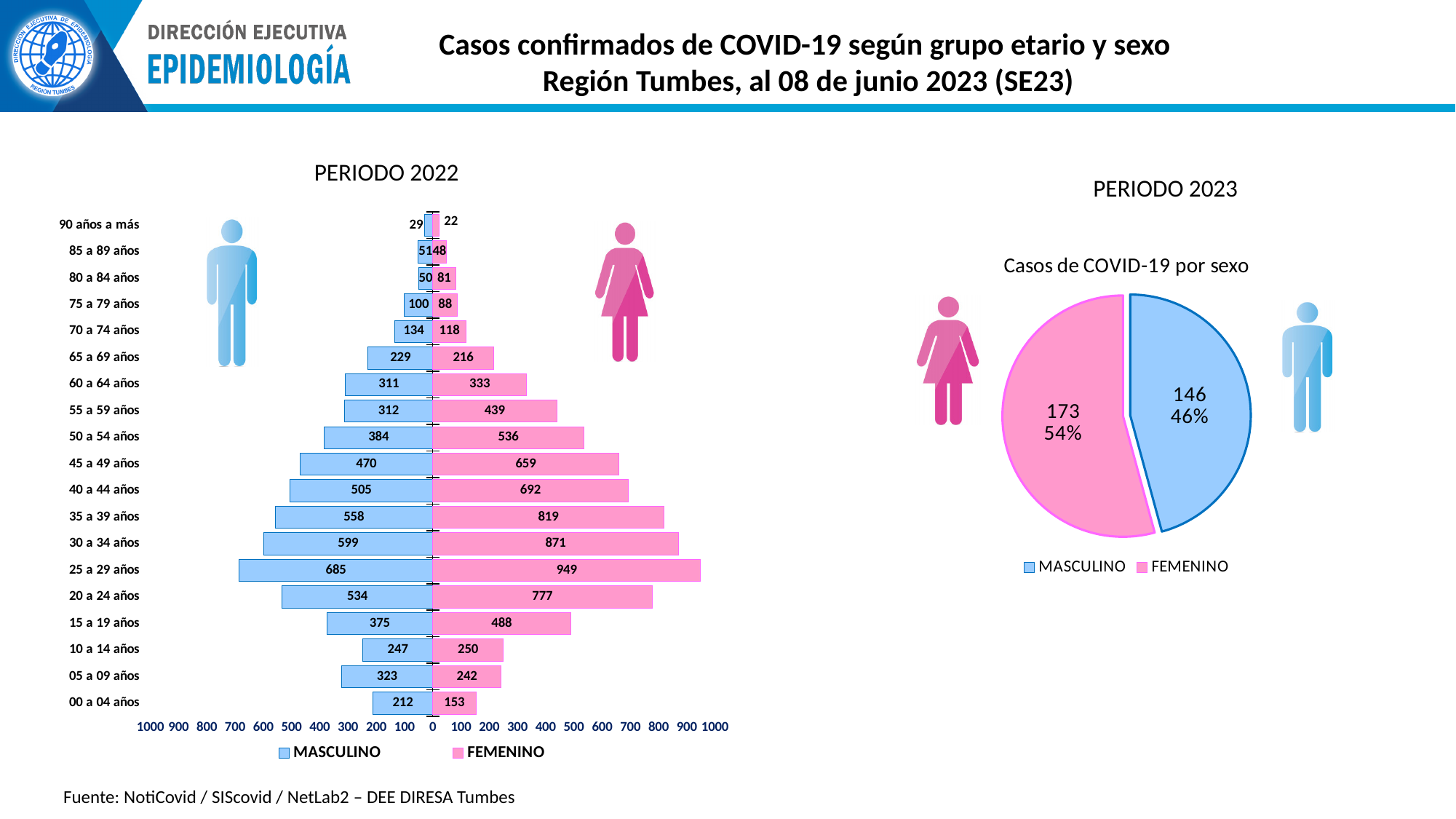
In the PERIODO 2022 chart, how many FEMENINO cases are shown for the 25 a 29 años group? 949 In the PERIODO 2022 chart, which age group has the highest number of MASCULINO cases? 25 a 29 años How many series does the legend of the PERIODO 2022 chart list? 2 What is the title of the PERIODO 2023 pie chart? Casos de COVID-19 por sexo In the PERIODO 2023 pie chart, how many MASCULINO cases are shown? 146 In the PERIODO 2022 chart, how many MASCULINO cases are shown for the 45 a 49 años group? 470 What kind of chart is the PERIODO 2022 chart? Bar chart In the PERIODO 2022 chart, which is larger for the 05 a 09 años group, MASCULINO or FEMENINO? MASCULINO In the PERIODO 2022 chart, what is the difference between FEMENINO and MASCULINO cases in the 30 a 34 años group? 272 How many age groups are shown in the PERIODO 2022 chart? 19 In the PERIODO 2023 pie chart, what share of cases is FEMENINO? 54% In the PERIODO 2022 chart, which age group has the lowest number of FEMENINO cases? 90 años a más